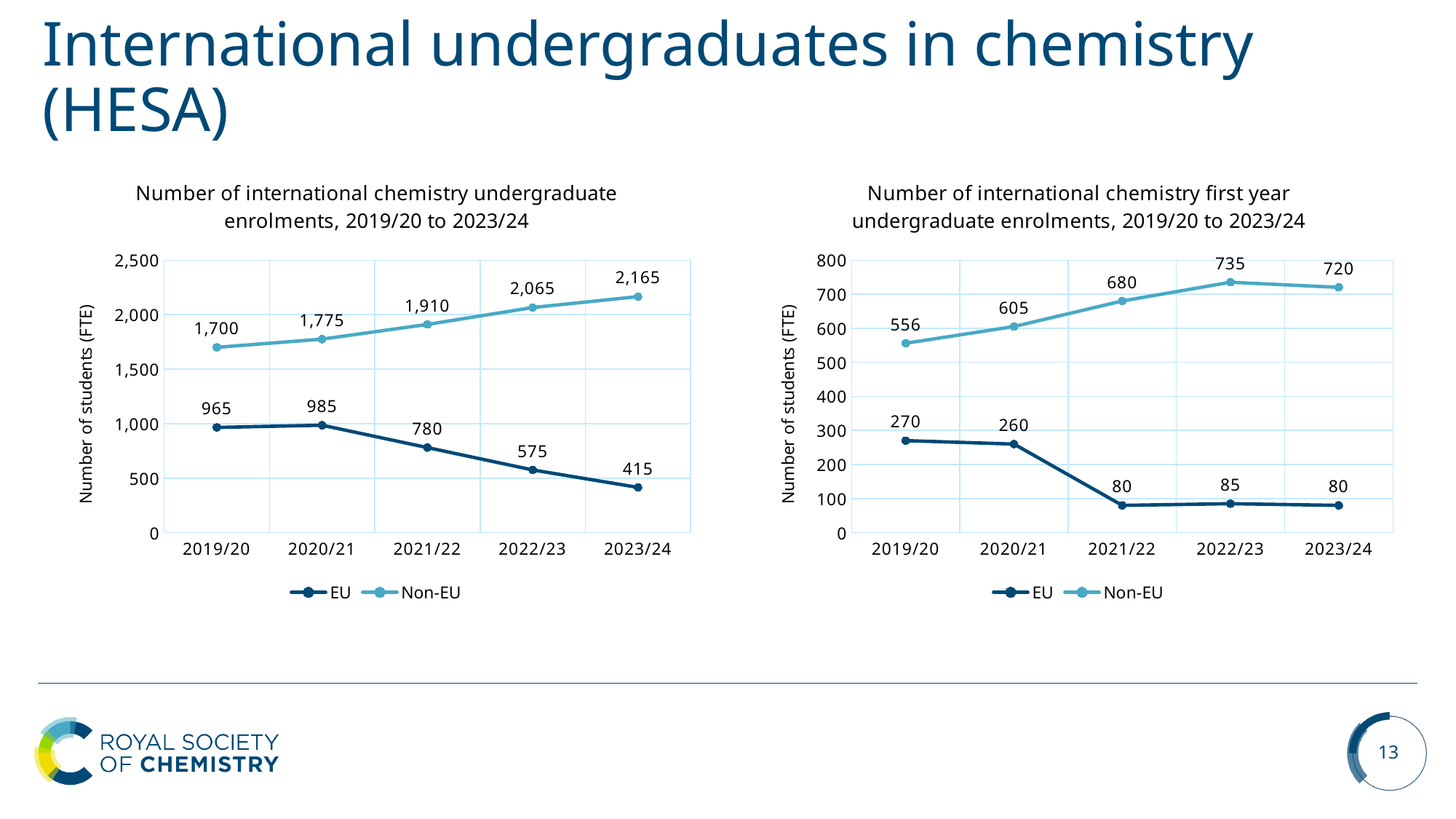
What kind of chart is the right chart (first year undergraduate enrolments)? line chart In the left chart (international chemistry undergraduate enrolments), what is the Non-EU value for 2023/24? 2,165 In the right chart (first year undergraduate enrolments), what is the Non-EU value for 2022/23? 735 In the right chart (first year undergraduate enrolments), by how much did the EU value fall from 2020/21 to 2021/22? 180 In the left chart (international chemistry undergraduate enrolments), what is the EU value for 2021/22? 780 In the left chart (international chemistry undergraduate enrolments), what is the difference between the Non-EU and EU values in 2023/24? 1,750 In the right chart (first year undergraduate enrolments), what is the EU value for 2019/20? 270 In the left chart (international chemistry undergraduate enrolments), in which year is the EU series lowest? 2023/24 How many series does the legend of the left chart list? 2 In the left chart (international chemistry undergraduate enrolments), does the EU series rise or fall from 2020/21 to 2023/24? fall In the right chart (first year undergraduate enrolments), does the Non-EU series rise or fall from 2019/20 to 2022/23? rise In the right chart (first year undergraduate enrolments), in which year is the Non-EU series highest? 2022/23